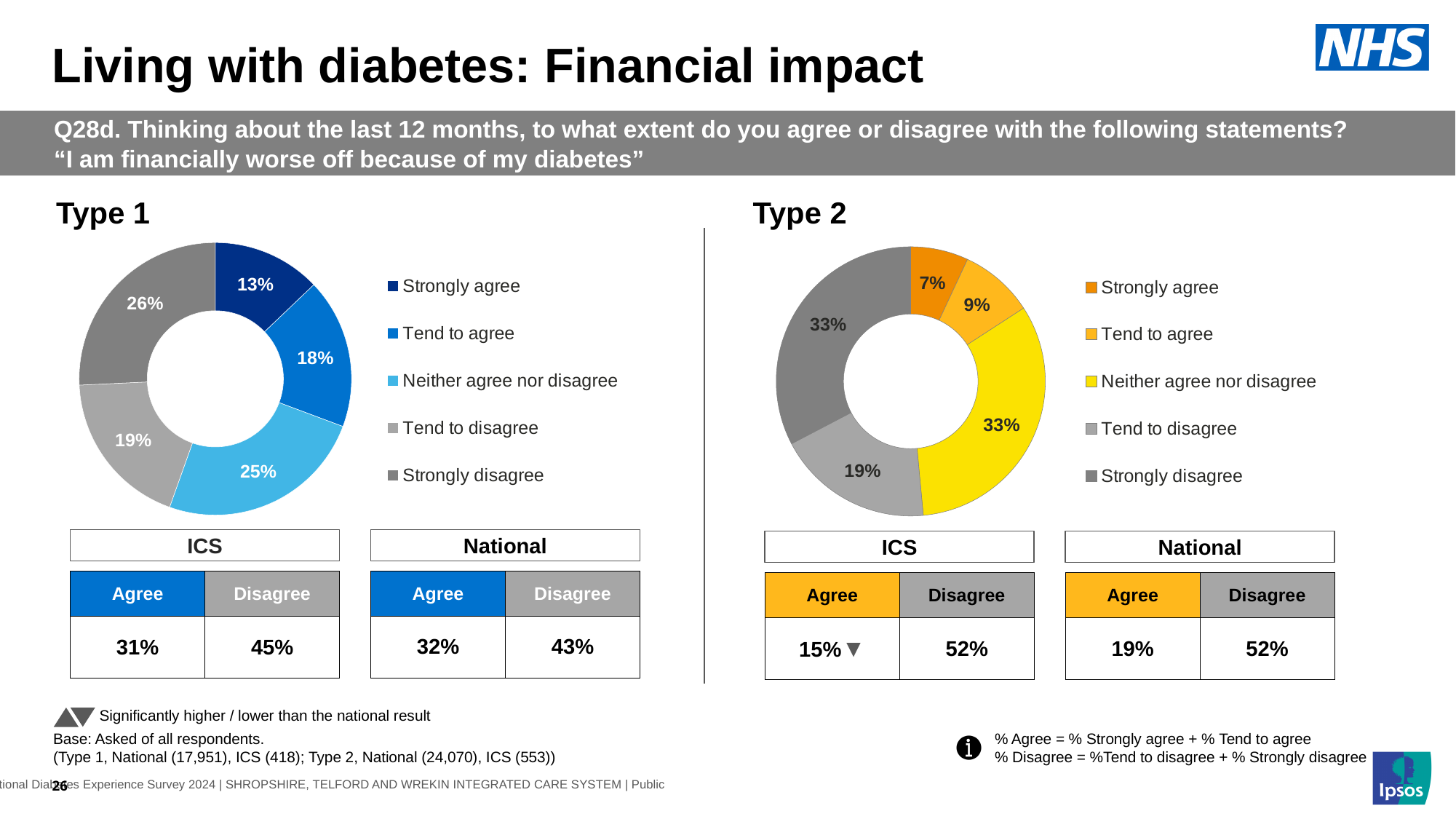
In the Type 1 chart, what percentage of respondents said they strongly agree? 13% How many response categories does the legend of the Type 2 chart list? 5 In the Type 2 chart, which response category has the smallest share? Strongly agree In the Type 2 chart, what percentage of respondents said they tend to agree? 9% In the Type 1 chart, which response category has the smallest share? Strongly agree In the Type 2 chart, what colour is the Neither agree nor disagree segment? Yellow In the Type 2 chart, what percentage of respondents said they tend to disagree? 19% In the Type 1 chart, what is the difference between the Strongly disagree share and the Strongly agree share? 13% In the Type 1 chart, what percentage of respondents said they neither agree nor disagree? 25% What type of chart is used to show the Type 1 results? Donut (pie) chart In the Type 2 chart, which is larger: the Tend to agree share or the Tend to disagree share? Tend to disagree In the Type 1 chart, which response category has the largest share? Strongly disagree